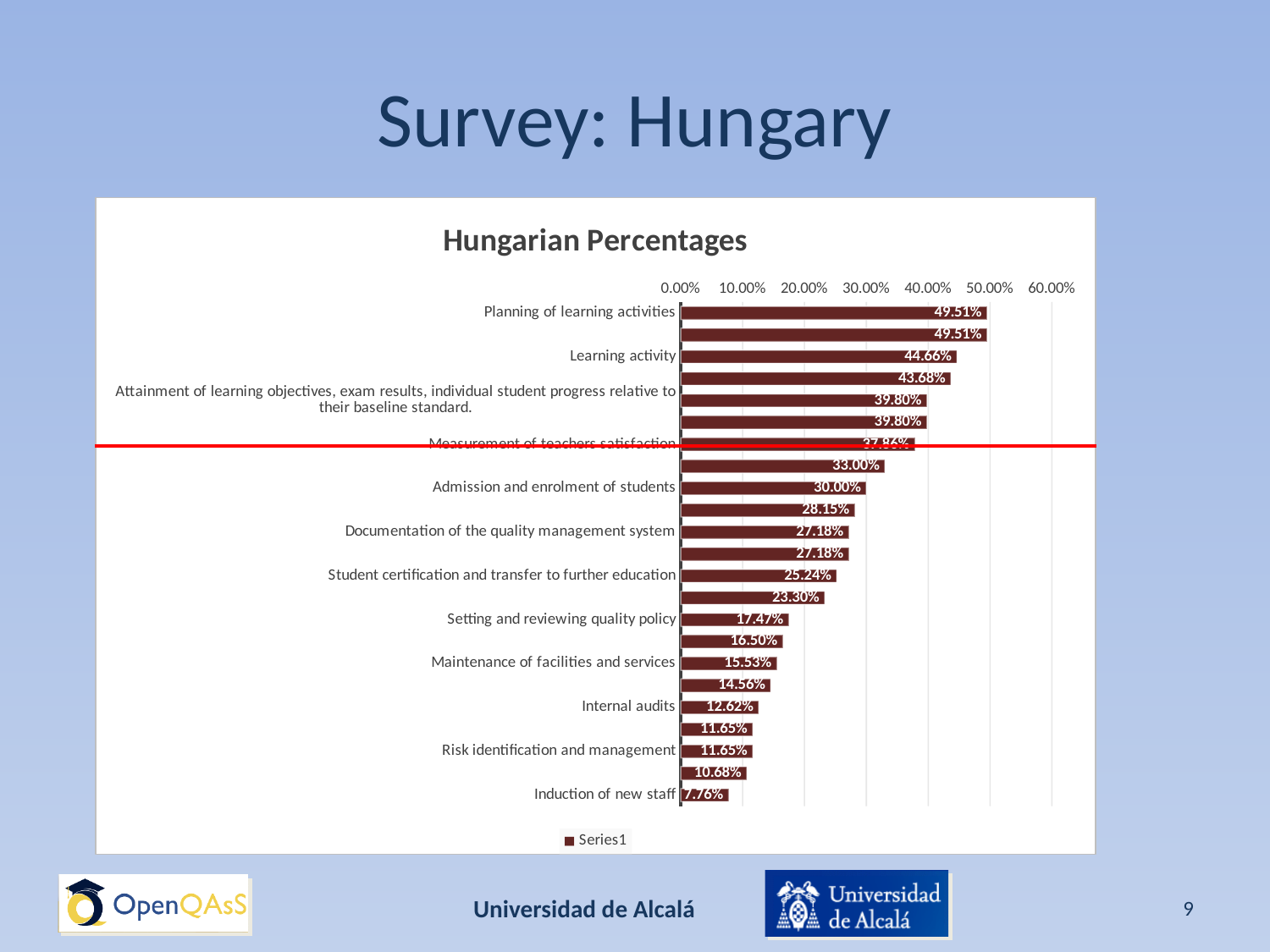
What is the value for Learning activity? 44.66% What is the highest value shown in the chart? 49.51% What is the value for Planning of learning activities? 49.51% What is the value for Internal audits? 12.62% Which is larger, the value for Documentation of the quality management system or the value for Student certification and transfer to further education? Documentation of the quality management system What is the title of the chart? Hungarian Percentages What is the difference between the values for Learning activity and Admission and enrolment of students? 14.66% Which category has the lowest value? Induction of new staff What type of chart is shown on the slide? Bar chart Is the value for Setting and reviewing quality policy greater or less than 20.00%? less How many series does the legend list? 1 What is the value for Induction of new staff? 7.76%